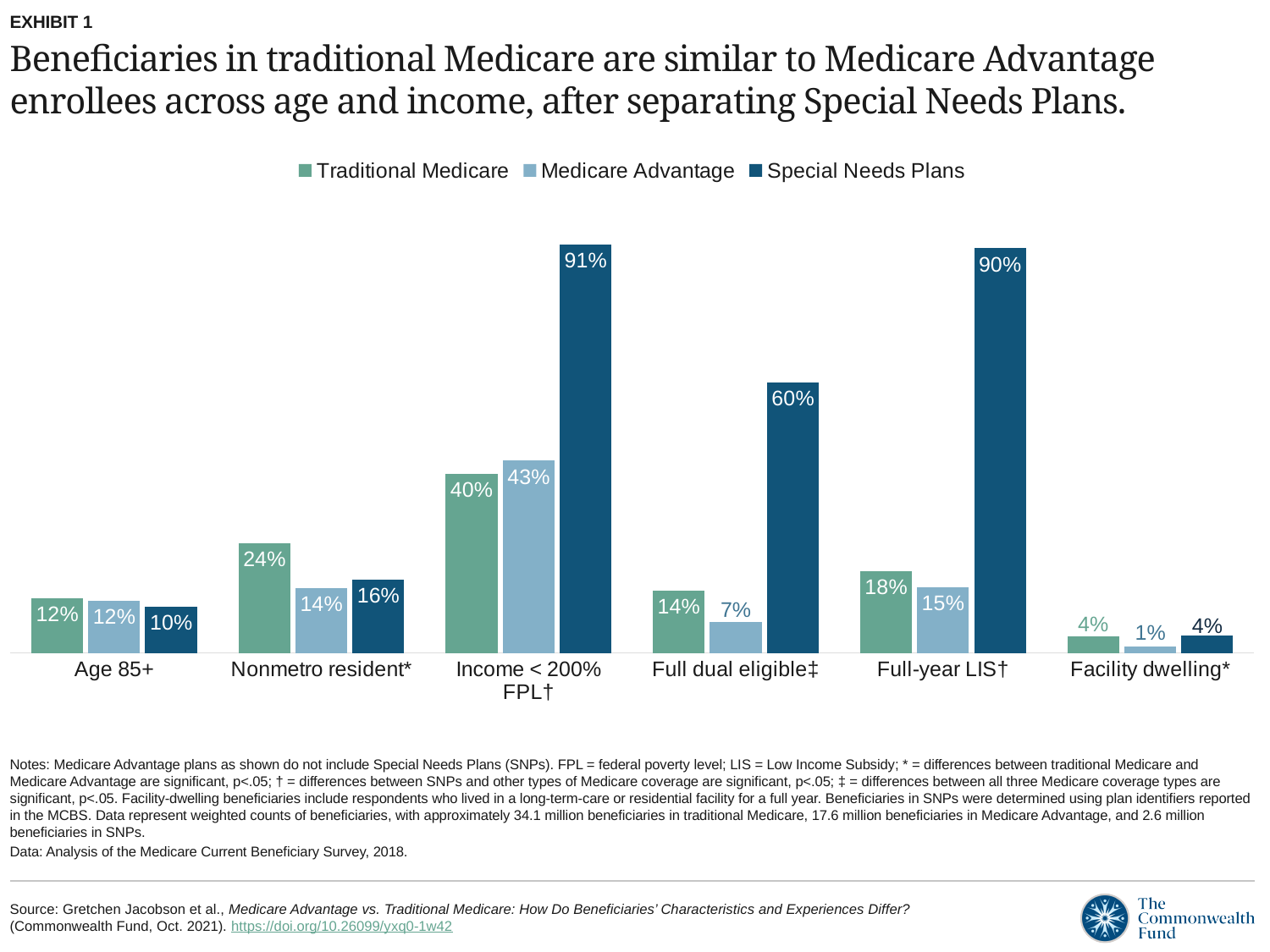
How many series does the legend list? 3 In the Income < 200% FPL† category, which is larger: Traditional Medicare or Medicare Advantage? Medicare Advantage What is the difference between the Special Needs Plans and Traditional Medicare values in the Full-year LIS† category? 72% Which series is shown in the darkest blue colour in the legend? Special Needs Plans What is the value for Medicare Advantage in the Full dual eligible‡ category? 7% How many categories are shown on the x axis? 6 What is the value for Traditional Medicare in the Nonmetro resident* category? 24% What is the value for Special Needs Plans in the Income < 200% FPL† category? 91% What is the difference between the Traditional Medicare and Medicare Advantage values in the Nonmetro resident* category? 10% What kind of chart is shown on the slide? Bar chart Which category has the highest value for Special Needs Plans? Income < 200% FPL† Which category has the lowest value for Medicare Advantage? Facility dwelling*